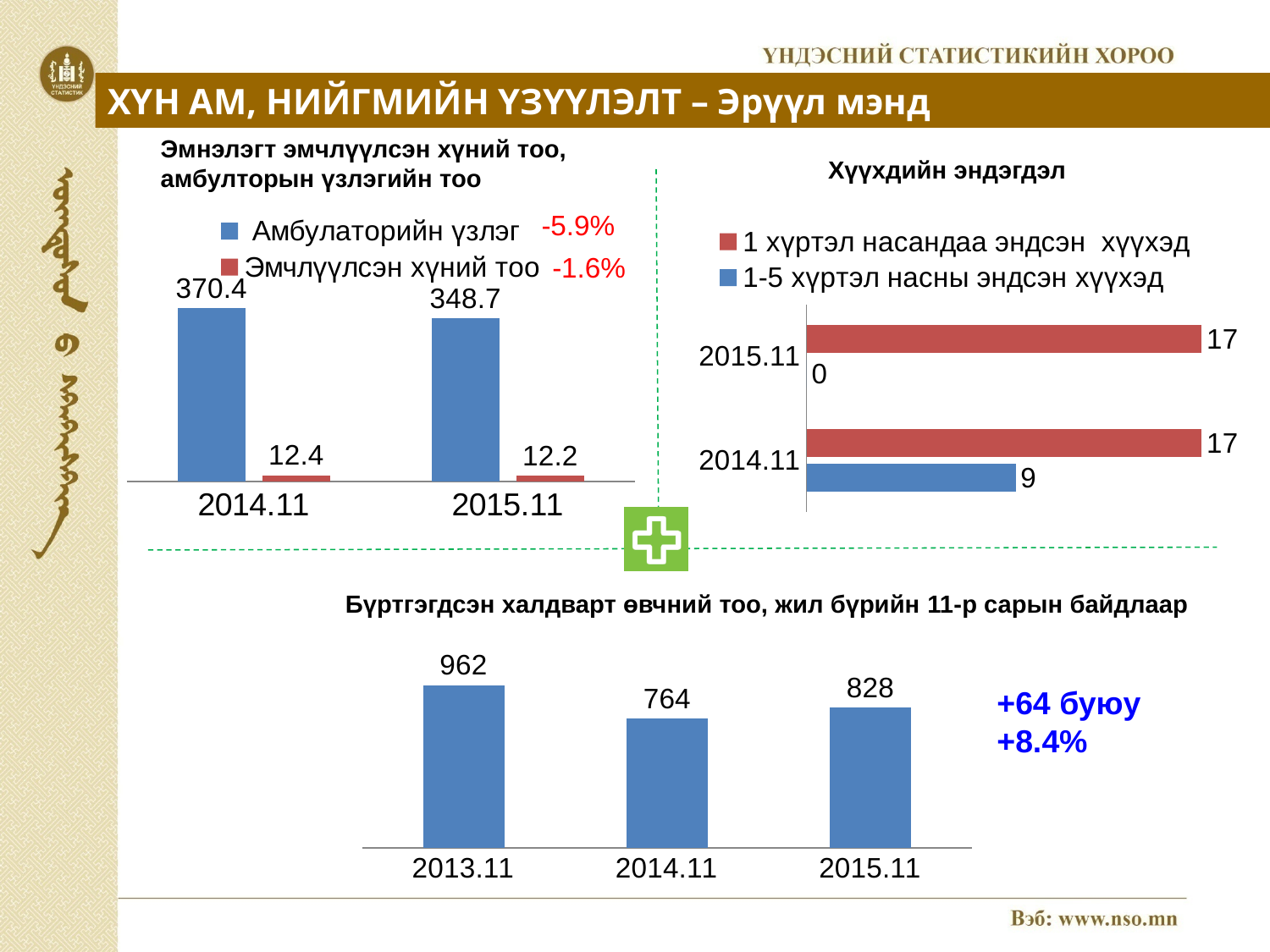
In the bottom chart 'Бүртгэгдсэн халдварт өвчний тоо, жил бүрийн 11-р сарын байдлаар', what is the difference between the values for 2015.11 and 2014.11? 64 In the top-left chart 'Эмнэлэгт эмчлүүлсэн хүний тоо, амбулторын үзлэгийн тоо', what is the value of 'Амбулаторийн үзлэг' for 2015.11? 348.7 In the top-left chart 'Эмнэлэгт эмчлүүлсэн хүний тоо, амбулторын үзлэгийн тоо', does 'Амбулаторийн үзлэг' rise or fall from 2014.11 to 2015.11? fall How many series does the legend of the top-left chart 'Эмнэлэгт эмчлүүлсэн хүний тоо, амбулторын үзлэгийн тоо' list? 2 How many periods are shown on the x axis of the bottom chart 'Бүртгэгдсэн халдварт өвчний тоо, жил бүрийн 11-р сарын байдлаар'? 3 In the top-right chart 'Хүүхдийн эндэгдэл', what is the value of '1-5 хүртэл насны эндсэн хүүхэд' for 2014.11? 9 In the top-right chart 'Хүүхдийн эндэгдэл', what is the value of '1 хүртэл насандаа эндсэн хүүхэд' for 2015.11? 17 In the top-left chart 'Эмнэлэгт эмчлүүлсэн хүний тоо, амбулторын үзлэгийн тоо', what is the value of 'Эмчлүүлсэн хүний тоо' for 2014.11? 12.4 In the bottom chart 'Бүртгэгдсэн халдварт өвчний тоо, жил бүрийн 11-р сарын байдлаар', what is the value for 2013.11? 962 In the bottom chart 'Бүртгэгдсэн халдварт өвчний тоо, жил бүрийн 11-р сарын байдлаар', which period has the lowest value? 2014.11 What kind of chart is the top-right chart 'Хүүхдийн эндэгдэл'? bar chart In the top-right chart 'Хүүхдийн эндэгдэл', which is larger for 2014.11: '1 хүртэл насандаа эндсэн хүүхэд' or '1-5 хүртэл насны эндсэн хүүхэд'? 1 хүртэл насандаа эндсэн хүүхэд